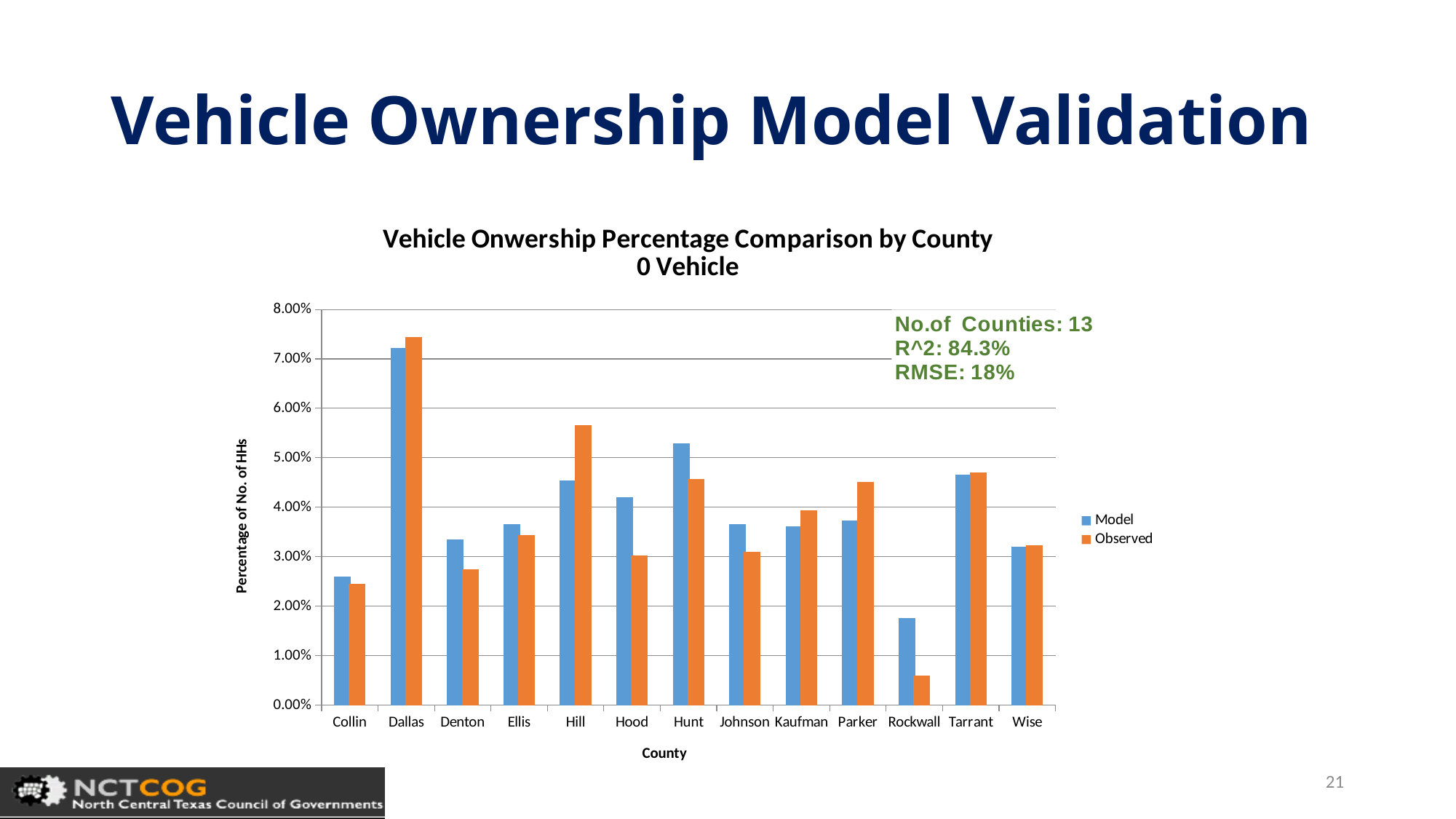
What are the two series named in the chart's legend? Model and Observed Is the Observed value for Rockwall greater or less than 1.00%? less Which county has the lowest Observed value? Rockwall For Hood, which is larger, the Model value or the Observed value? Model Is the Observed value for Denton greater or less than 3.00%? less What kind of chart is shown on the slide? bar chart For Parker, which is larger, the Model value or the Observed value? Observed How many counties are shown on the x axis of the chart? 13 Is the Observed value for Hill greater or less than 5.00%? greater Which county has the highest Model value? Dallas How many series does the chart's legend list? 2